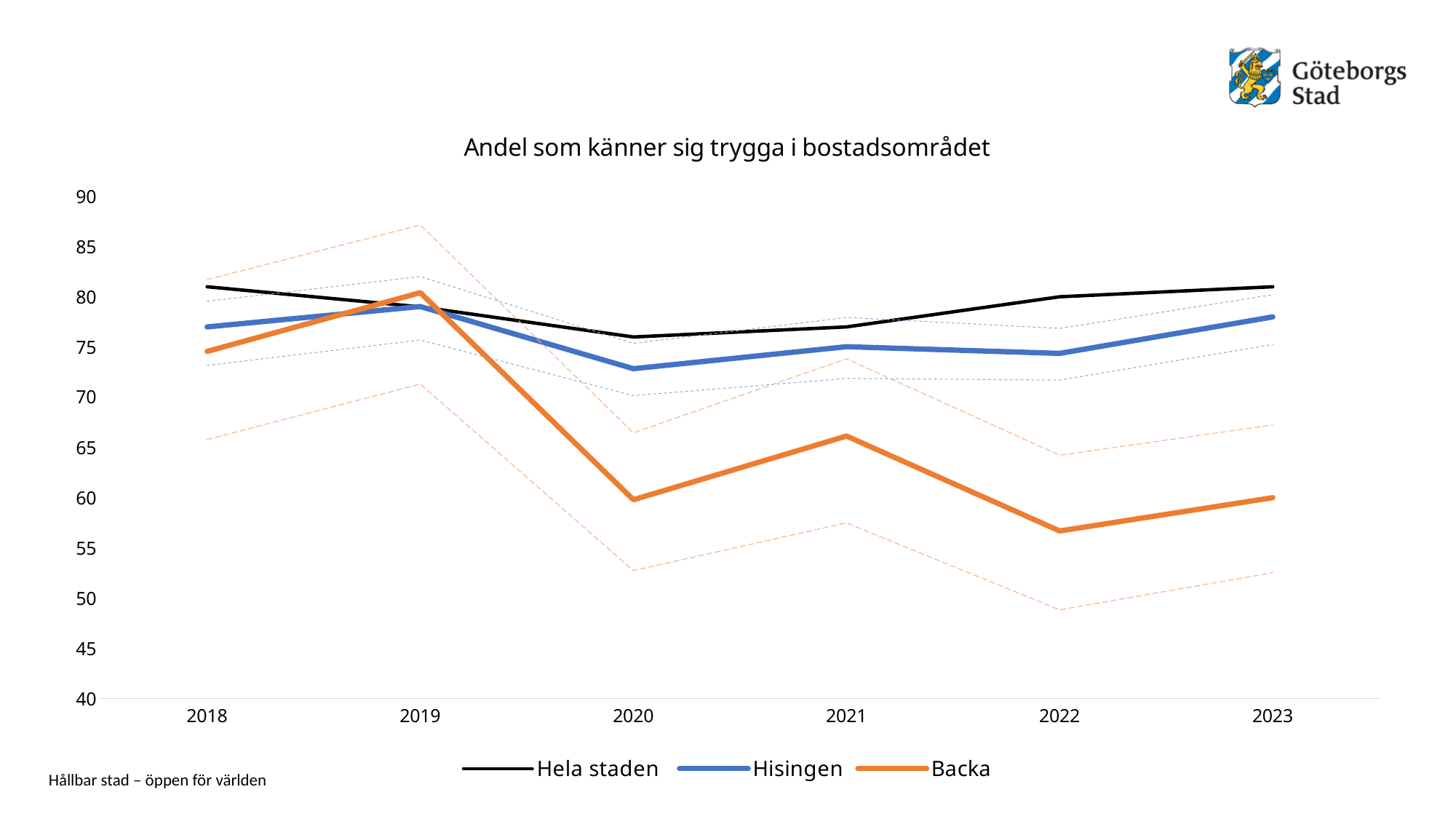
In which year is the value for Backa highest? 2019 What is the title of the chart? Andel som känner sig trygga i bostadsområdet Is the value for Backa in 2019 greater or less than 75? greater Is the value for Hisingen in 2020 greater or less than 75? less Is the value for Backa in 2020 greater or less than 65? less How many series does the legend list? 3 What kind of chart is shown on the slide? line chart In which year is the value for Backa lowest? 2022 Which colour is used for the Backa line? orange How many years are shown on the x axis? 6 Does the value for Backa rise or fall from 2019 to 2020? fall In 2020, which is larger: the value for Hela staden or the value for Backa? Hela staden